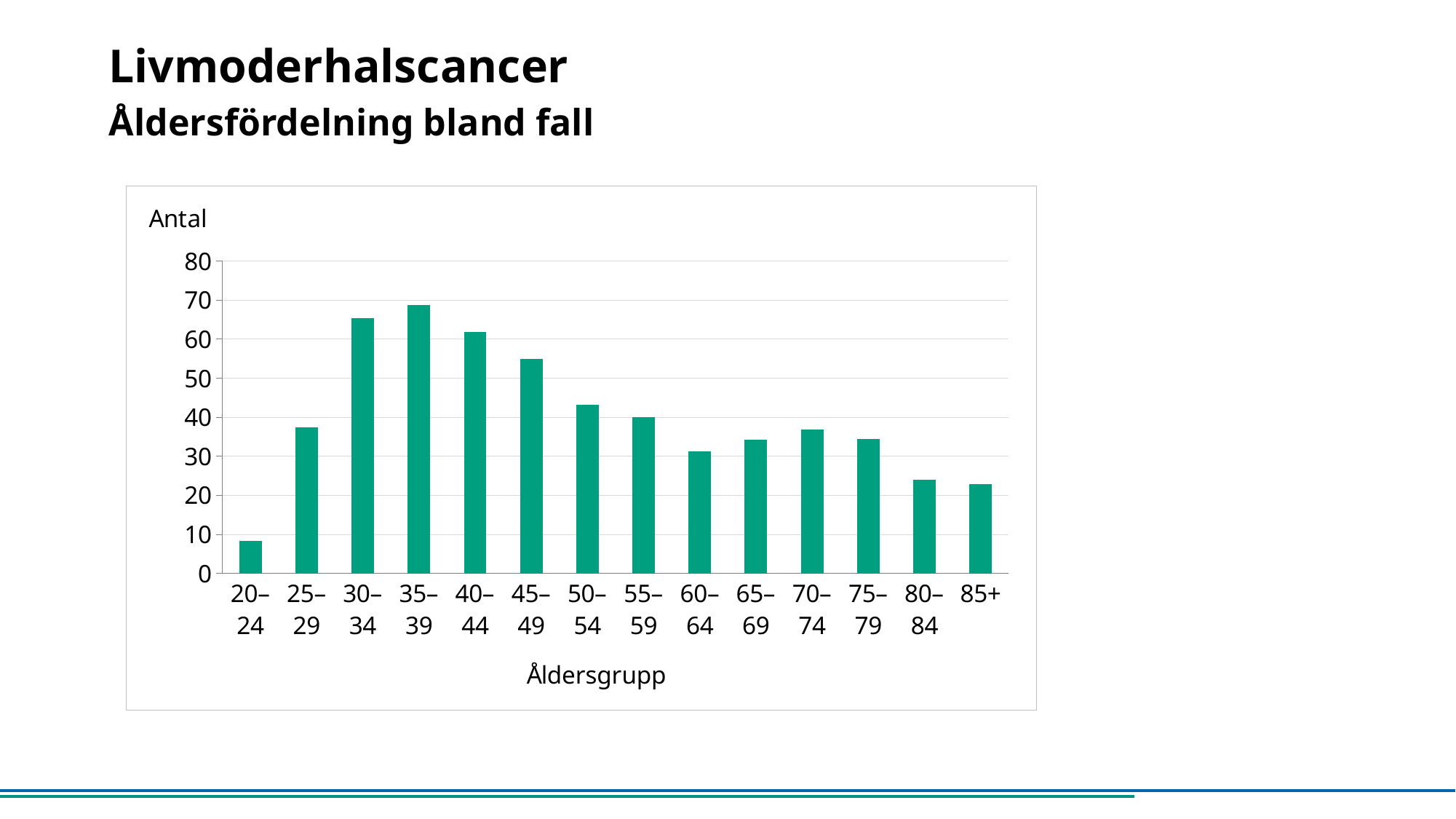
What kind of chart is shown on the slide? Bar chart Is the value for the 20–24 age group greater or less than 10? less Is the value for the 80–84 age group greater or less than 30? less Is the value for the 30–34 age group greater or less than 60? greater Which age group has the lowest number of cases? 20–24 What is the label on the vertical axis of the chart? Antal Do the values rise or fall from the 35–39 age group to the 60–64 age group? Fall How many age groups are shown on the x axis? 14 Which age group has the highest number of cases? 35–39 Which has more cases, the 30–34 age group or the 60–64 age group? 30–34 Which has more cases, the 25–29 age group or the 85+ age group? 25–29